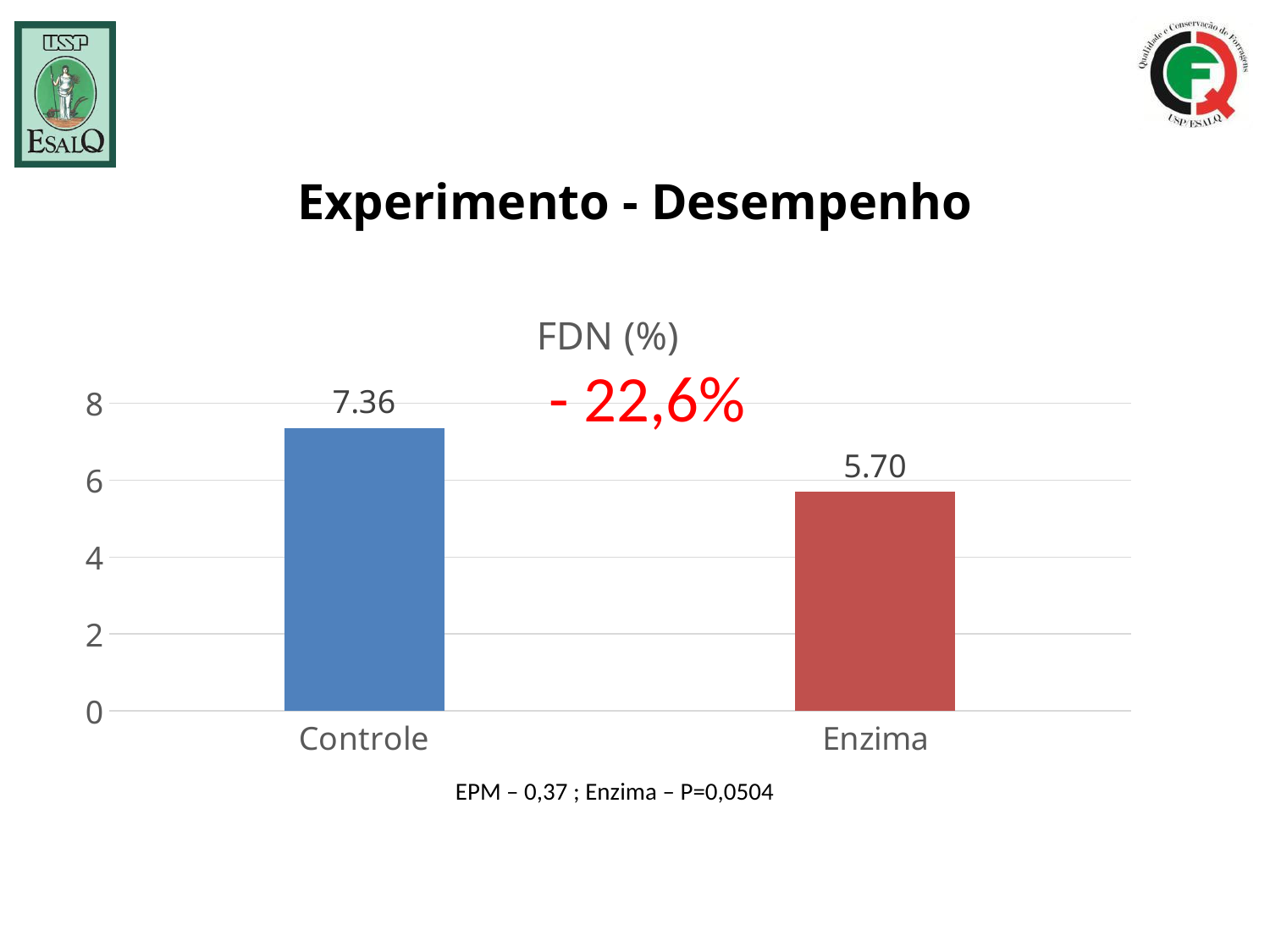
What is the value for Controle? 7.36 Is the value for Enzima greater or less than 6? less What is the value for Enzima? 5.70 Is the value for Controle greater or less than 6? greater What is the difference between the values for Controle and Enzima? 1.66 Which is larger, the value for Controle or the value for Enzima? Controle Which category has the highest value? Controle What kind of chart is shown? bar chart Which category has the lowest value? Enzima What percentage change is printed in red on the chart? - 22,6% What is the title of the chart? FDN (%) How many categories are shown on the x axis? 2